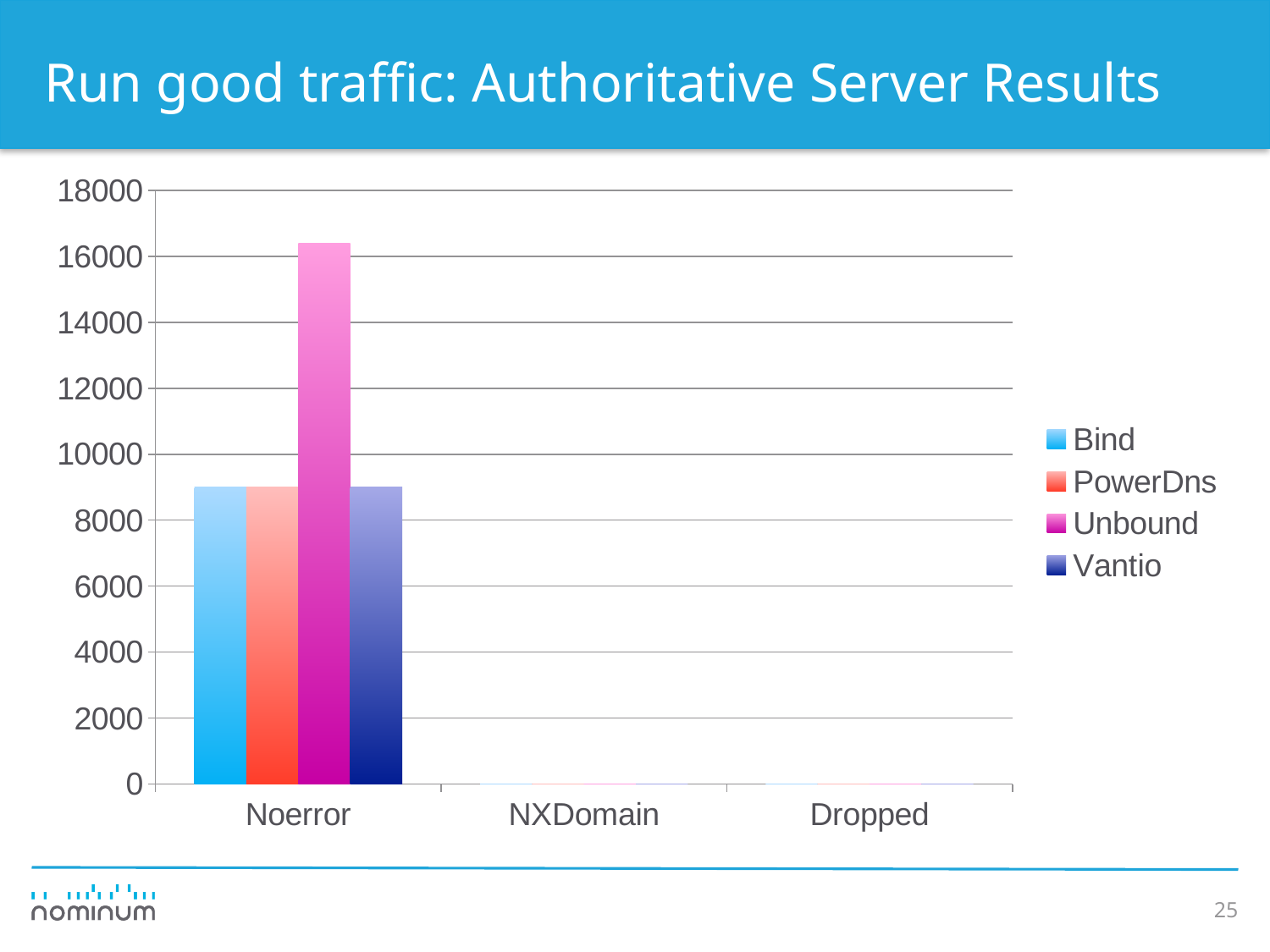
For Noerror, which is larger: the Unbound value or the Bind value? Unbound Is the Unbound value for Noerror greater or less than 14000? greater Is the PowerDns value for Noerror greater or less than 12000? less How many categories are shown on the x axis? 3 What is the title of the slide containing the chart? Run good traffic: Authoritative Server Results Which category has the highest values across all series? Noerror Is the Bind value for Noerror greater or less than 10000? less Which series has the highest value for Noerror? Unbound Do the Unbound values rise or fall from Noerror to Dropped? fall How many series does the legend list? 4 What kind of chart is shown on the slide? bar chart